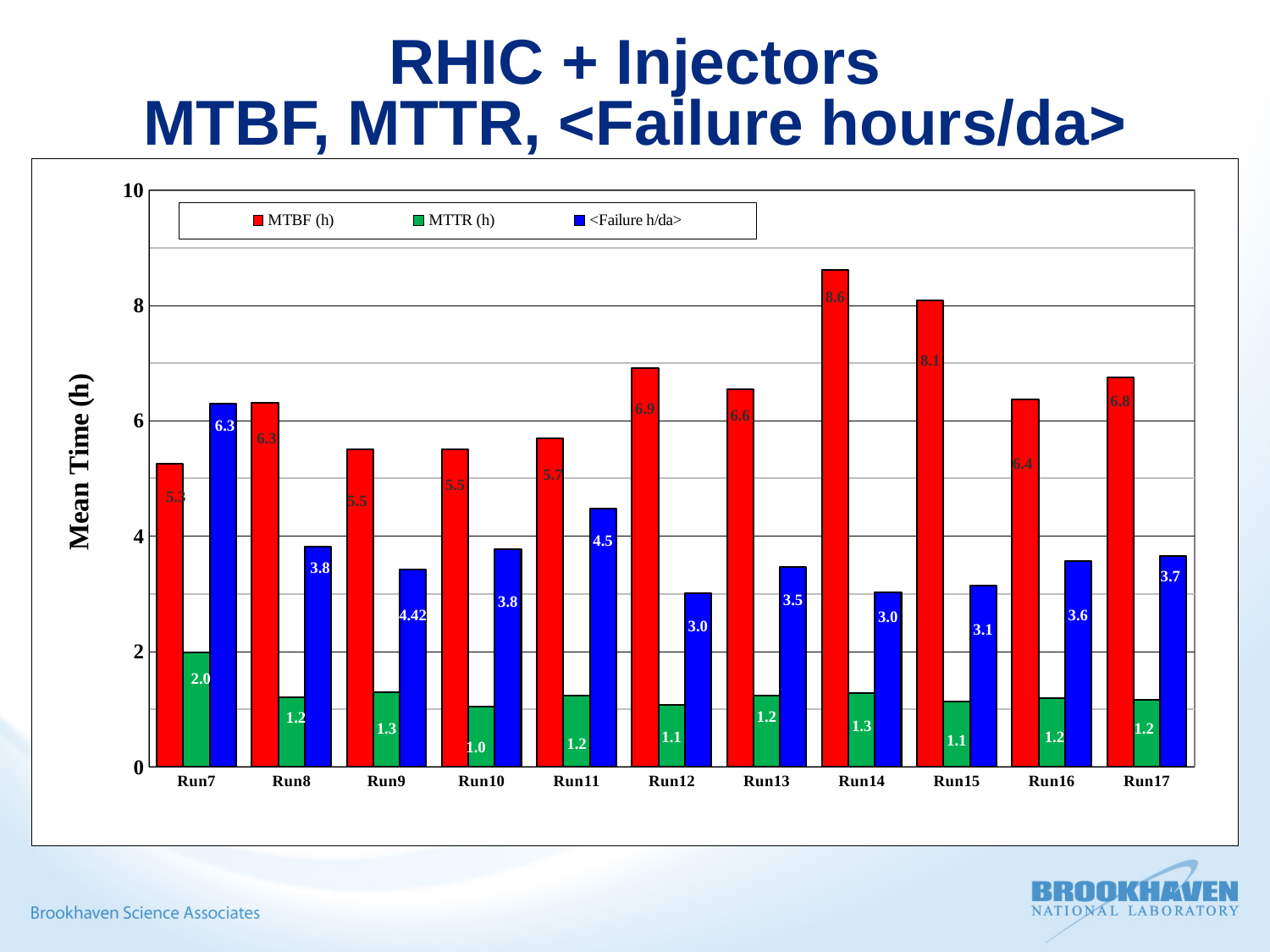
What is the MTBF (h) value for Run14? 8.6 Is the MTBF (h) value for Run15 greater or less than 8? greater How many series does the legend list? 3 Which run has the highest <Failure h/da> value? Run7 What is the MTTR (h) value for Run7? 2.0 What is the <Failure h/da> value for Run11? 4.5 Which is larger, the MTBF (h) for Run12 or the MTBF (h) for Run13? Run12 How many runs are shown on the x axis? 11 Which run has the lowest MTTR (h)? Run10 Which run has the highest MTBF (h)? Run14 What is the difference between the MTBF (h) values for Run14 and Run15? 0.5 What type of chart is shown on the slide? Bar chart